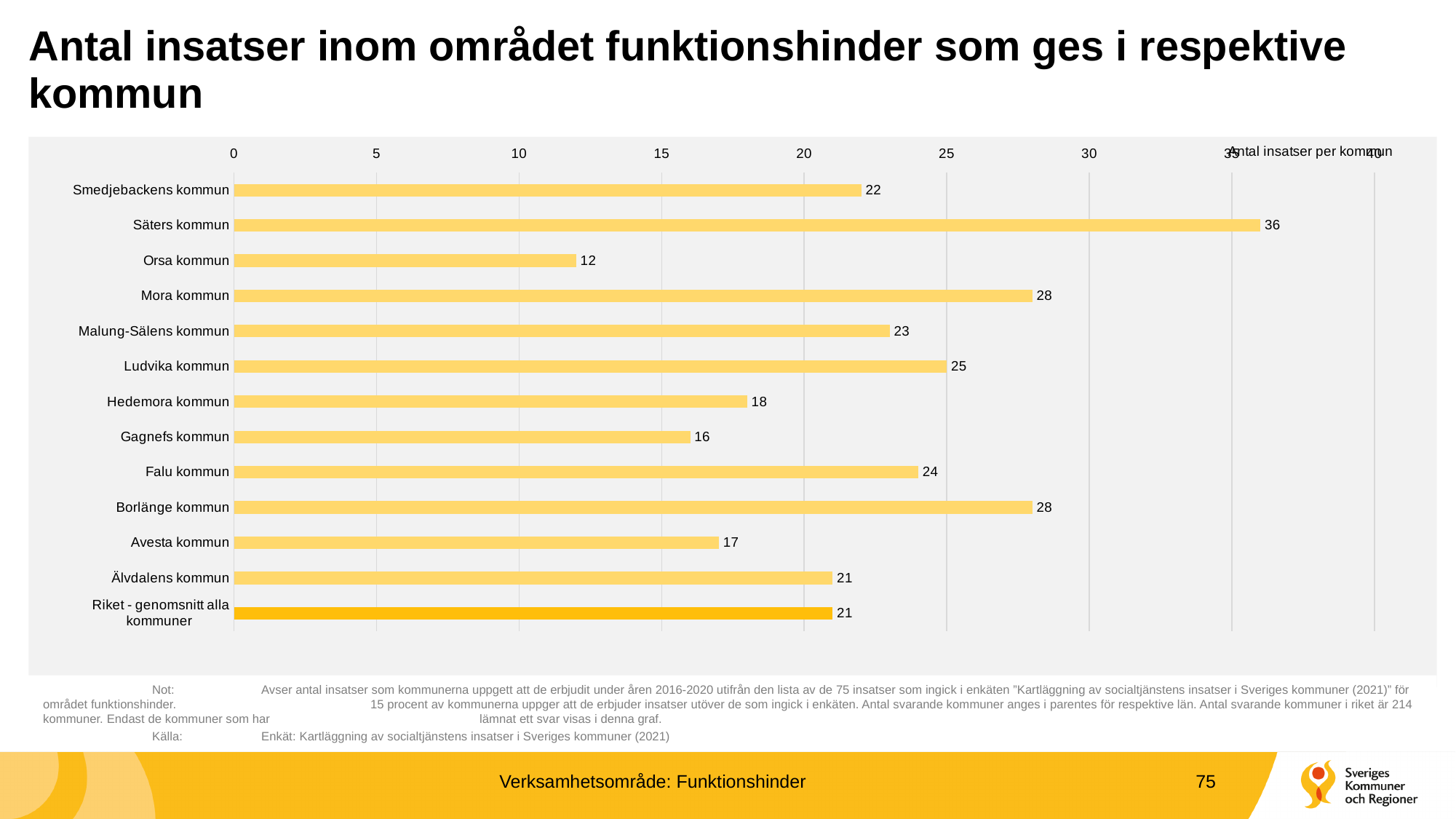
Which kommun has the highest number of insatser? Säters kommun What kind of chart is shown on the slide? Bar chart Which kommun has the lowest number of insatser? Orsa kommun What is the axis label shown at the top right of the chart? Antal insatser per kommun What is the difference between the values for Säters kommun and Orsa kommun? 24 What is the difference between the values for Borlänge kommun and Avesta kommun? 11 What is the value for Riket - genomsnitt alla kommuner? 21 How many categories (bars) are shown in the chart? 13 What is the value for Säters kommun? 36 What is the value for Orsa kommun? 12 Is the value for Mora kommun greater or less than 25? greater Which is larger, the value for Ludvika kommun or the value for Falu kommun? Ludvika kommun